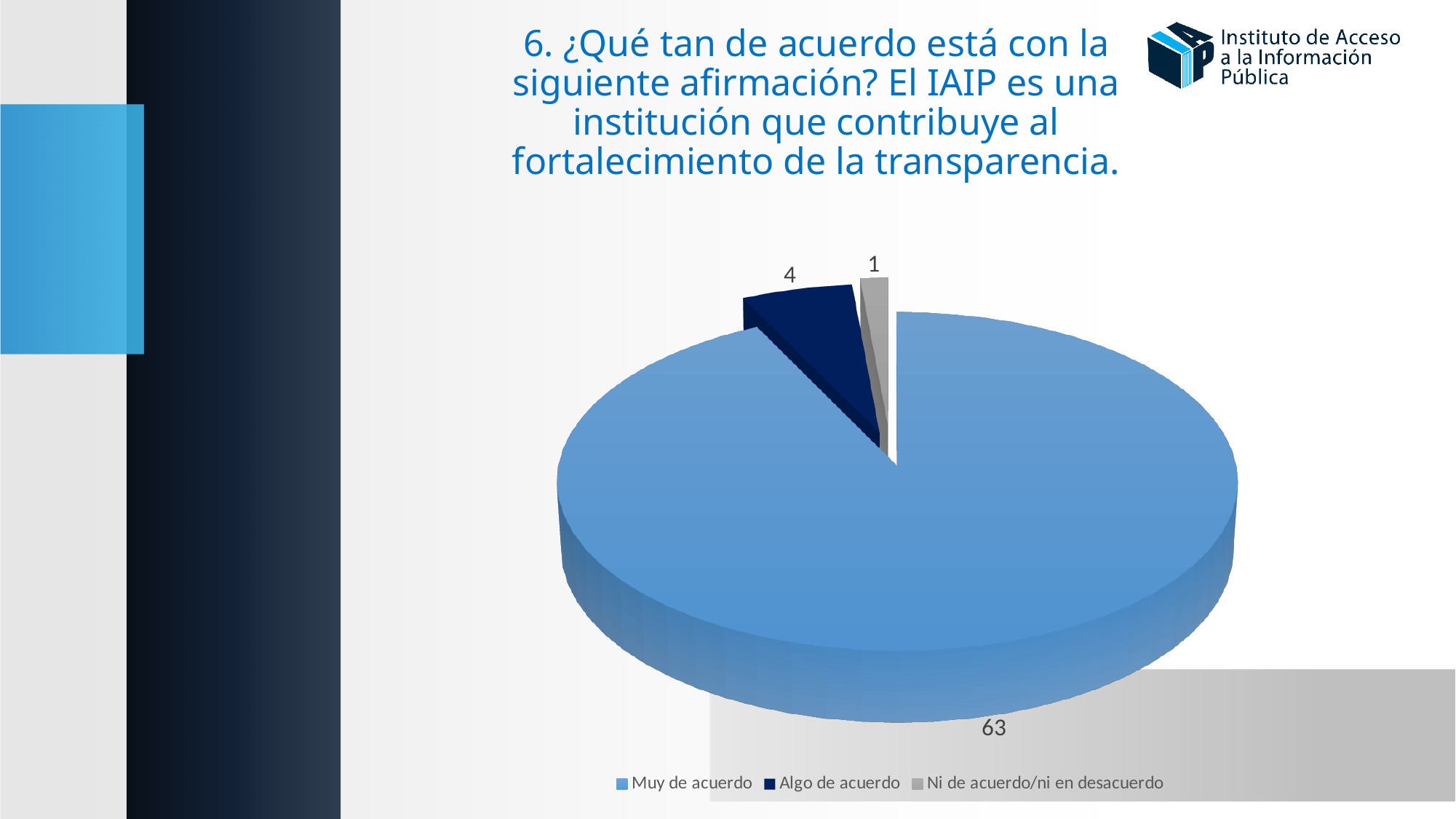
Which is larger, "Algo de acuerdo" or "Ni de acuerdo/ni en desacuerdo"? Algo de acuerdo What colour is the "Algo de acuerdo" slice? dark blue How many slices does the pie chart have? 3 Which category has the largest slice? Muy de acuerdo What is the value for "Ni de acuerdo/ni en desacuerdo"? 1 What is the total of all the slice values? 68 How many entries does the legend list? 3 What kind of chart is shown on the slide? pie chart Which category has the smallest slice? Ni de acuerdo/ni en desacuerdo What is the difference between the values for "Muy de acuerdo" and "Algo de acuerdo"? 59 What is the value for "Algo de acuerdo"? 4 What is the value for "Muy de acuerdo"? 63